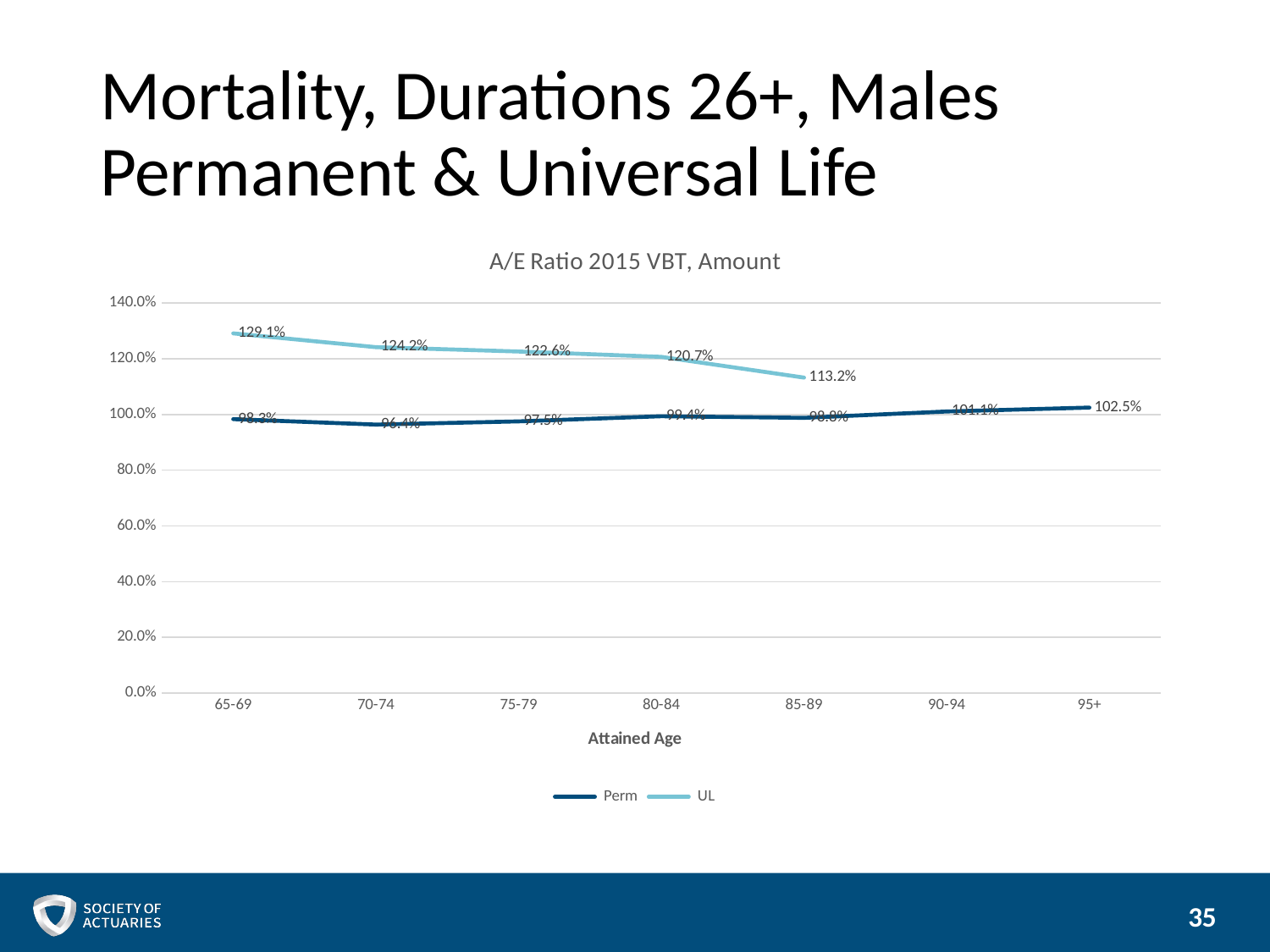
How many attained age categories are shown on the x axis? 7 How many series does the legend list? 2 What is the difference between the UL values at 65-69 and 85-89? 15.9 percentage points At which attained age is the UL series highest? 65-69 Does the UL series rise or fall as attained age increases? fall What kind of chart is shown on the slide? line chart What is the UL value for attained age 85-89? 113.2% At which attained age is the UL series lowest? 85-89 At attained age 80-84, which series has the higher value, Perm or UL? UL What is the title of the chart? A/E Ratio 2015 VBT, Amount What is the Perm value for attained age 95+? 102.5% What is the UL value for attained age 65-69? 129.1%